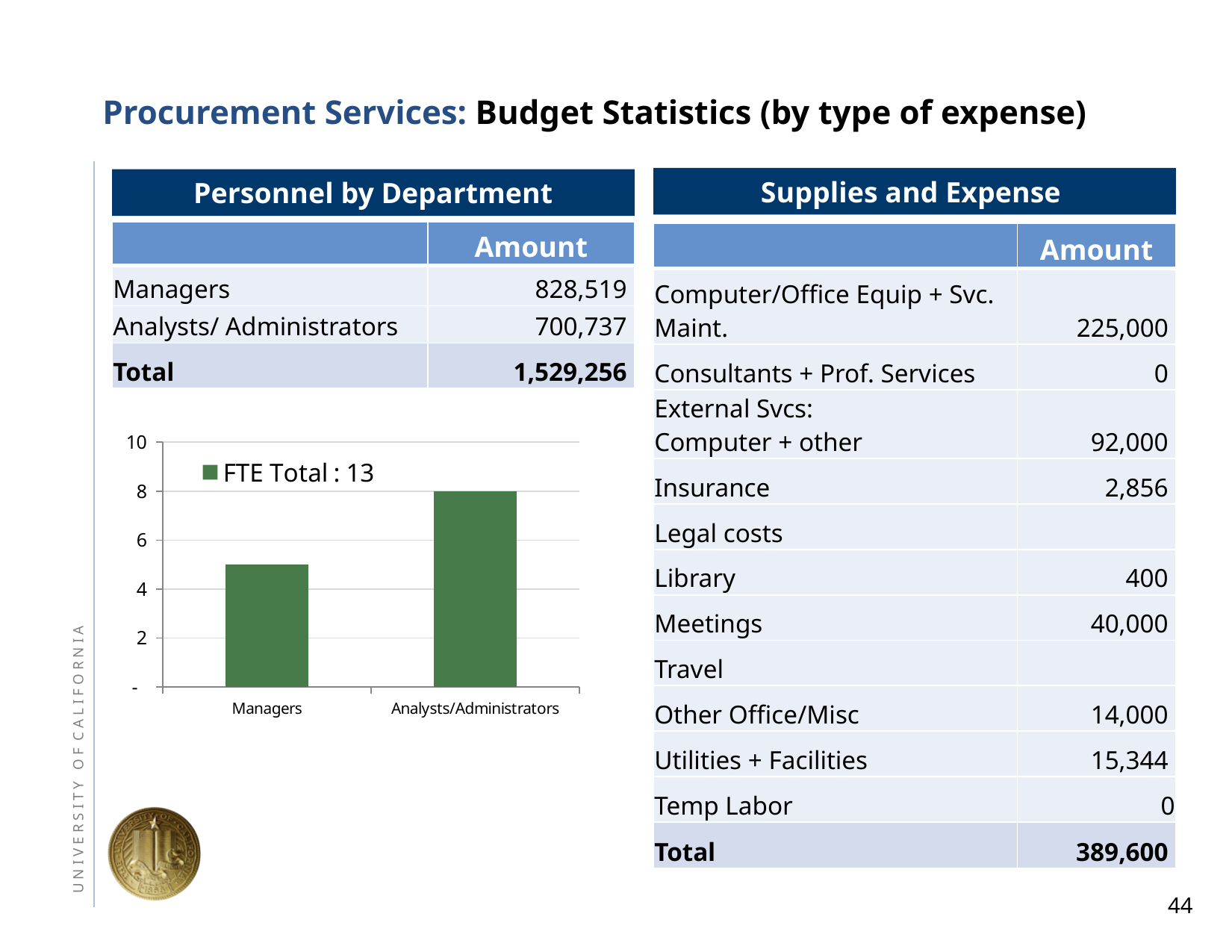
Is the value for Analysts/Administrators greater or less than 10? less Which category has the tallest bar in the chart? Analysts/Administrators What kind of chart is shown on the slide? bar chart What is the legend entry shown in the bar chart? FTE Total : 13 Is the value for Managers greater or less than 6? less What is the value of the bar for Analysts/Administrators? 8 Which category has the shortest bar in the chart? Managers How many series does the legend of the bar chart list? 1 Which bar is taller, Managers or Analysts/Administrators? Analysts/Administrators What colour are the bars in the chart? green Is the value for Managers greater or less than 4? greater How many categories are plotted on the x axis of the bar chart? 2